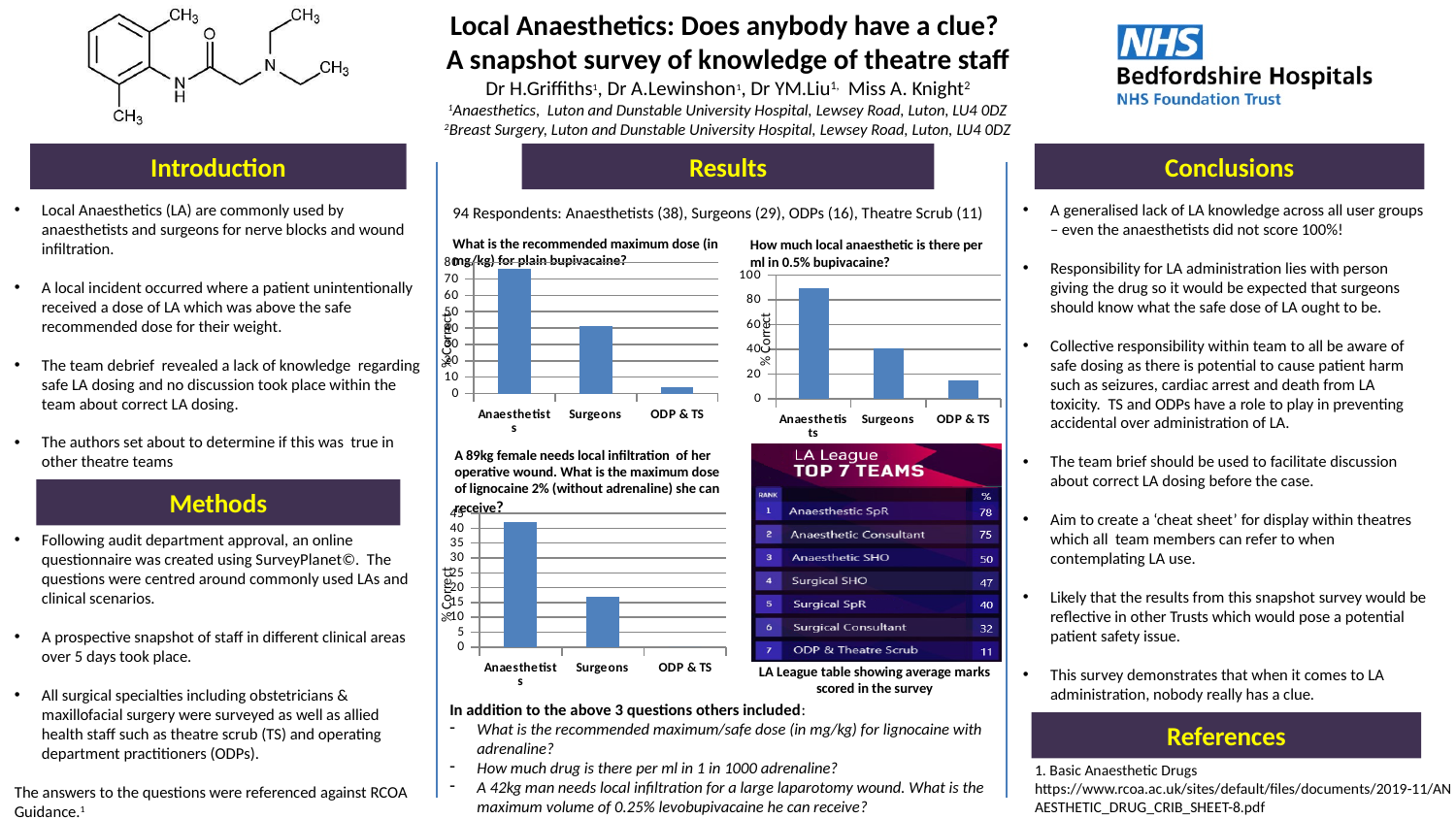
In the chart titled 'What is the recommended maximum dose (in mg/kg) for plain bupivacaine?', is the value for ODP & TS greater or less than 10? less In the chart about the 89kg female needing local infiltration of lignocaine 2%, is the value for Surgeons greater or less than 25? less In the chart about the 89kg female needing local infiltration of lignocaine 2%, is the value for Anaesthetists greater or less than 35? greater In the chart titled 'How much local anaesthetic is there per ml in 0.5% bupivacaine?', which is larger, the value for Surgeons or the value for ODP & TS? Surgeons In the chart about the 89kg female needing local infiltration of lignocaine 2%, do the values rise or fall from left to right across the groups? fall In the chart titled 'What is the recommended maximum dose (in mg/kg) for plain bupivacaine?', which group has the lowest % correct? ODP & TS What kind of chart is the chart titled 'What is the recommended maximum dose (in mg/kg) for plain bupivacaine?'? bar chart How many groups are shown in the chart titled 'How much local anaesthetic is there per ml in 0.5% bupivacaine?'? 3 In the chart titled 'What is the recommended maximum dose (in mg/kg) for plain bupivacaine?', which group has the highest % correct? Anaesthetists